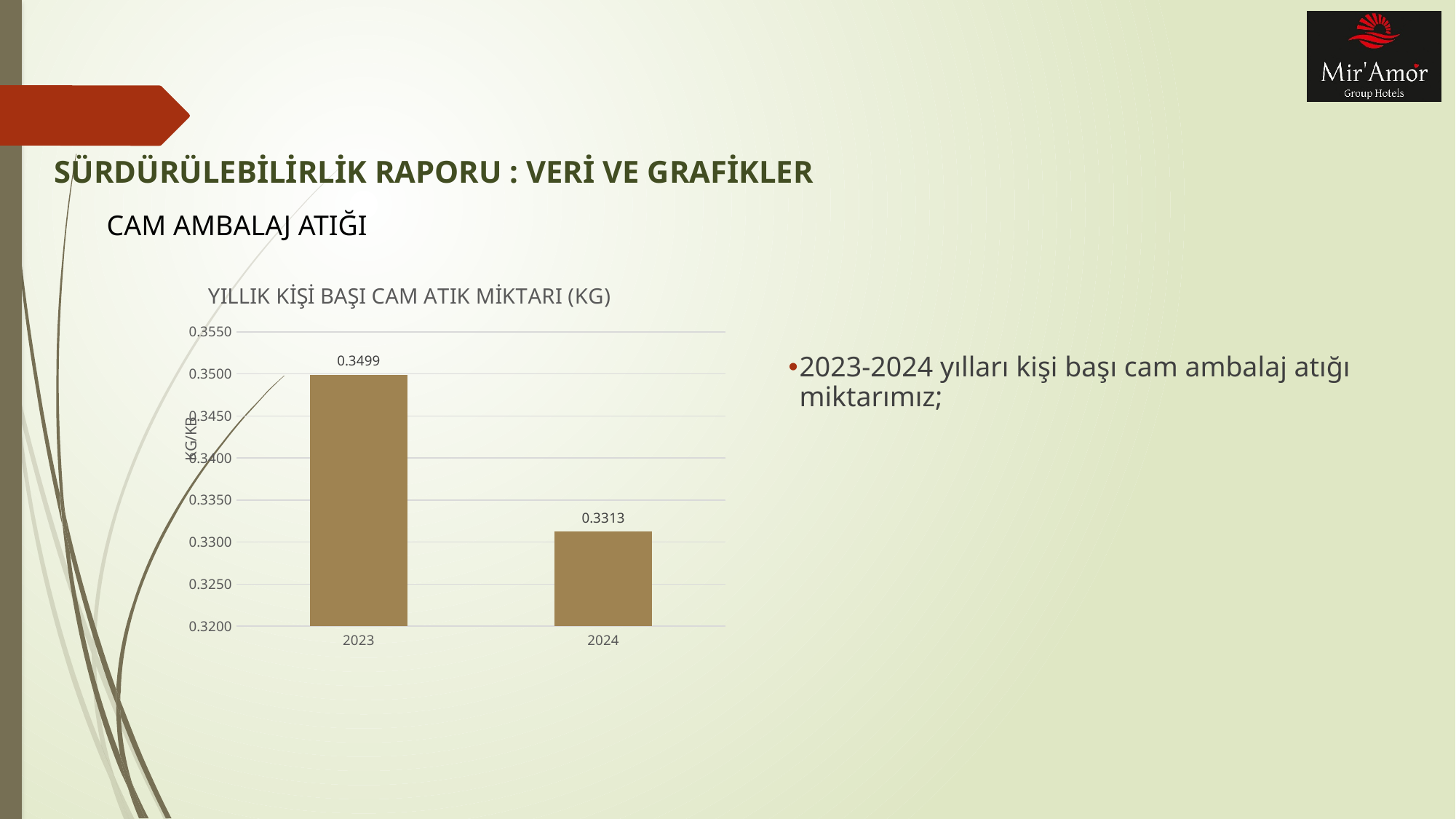
What is the title of the chart? YILLIK KİŞİ BAŞI CAM ATIK MİKTARI (KG) Which year has the lowest value? 2024 What is the difference between the values for 2023 and 2024? 0.0186 What is the value for 2023? 0.3499 Is the value for 2023 greater or less than 0.3450? greater Which is larger, the value for 2023 or the value for 2024? 2023 What is the value for 2024? 0.3313 How many years are shown on the x axis? 2 What kind of chart is shown? bar chart Do the values rise or fall from 2023 to 2024? fall Is the value for 2024 greater or less than 0.3350? less Which year has the highest value? 2023